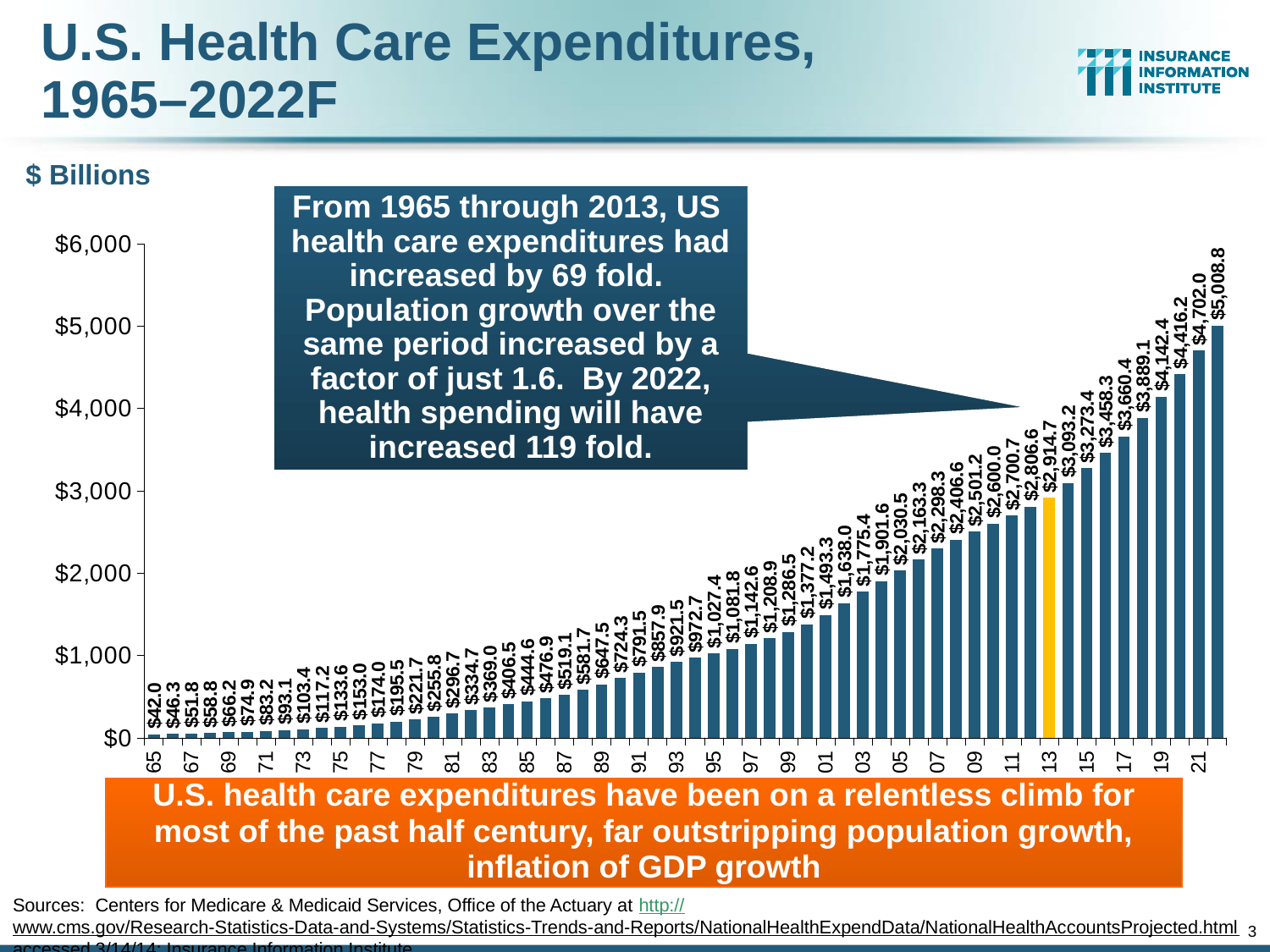
What is the value for 2000 (labelled 01 is the next bar)? $1,377.2 What is the value for 1965 (the first bar)? $42.0 What is the value of the highlighted (yellow) bar for 2013? $2,914.7 Which is larger, the value for 2005 or the value for 1995? 2005 Which year has the highest value? 2022 Is the value for 2017 greater or less than $3,000? greater What is the value for 2022 (the last bar)? $5,008.8 Do the values rise or fall from 1965 to 2022? Rise What is the difference between the 2022 value and the 2013 value? $2,094.1 Which year has the lowest value? 1965 How many bars (years) are plotted in the chart? 58 What kind of chart is shown? Bar chart